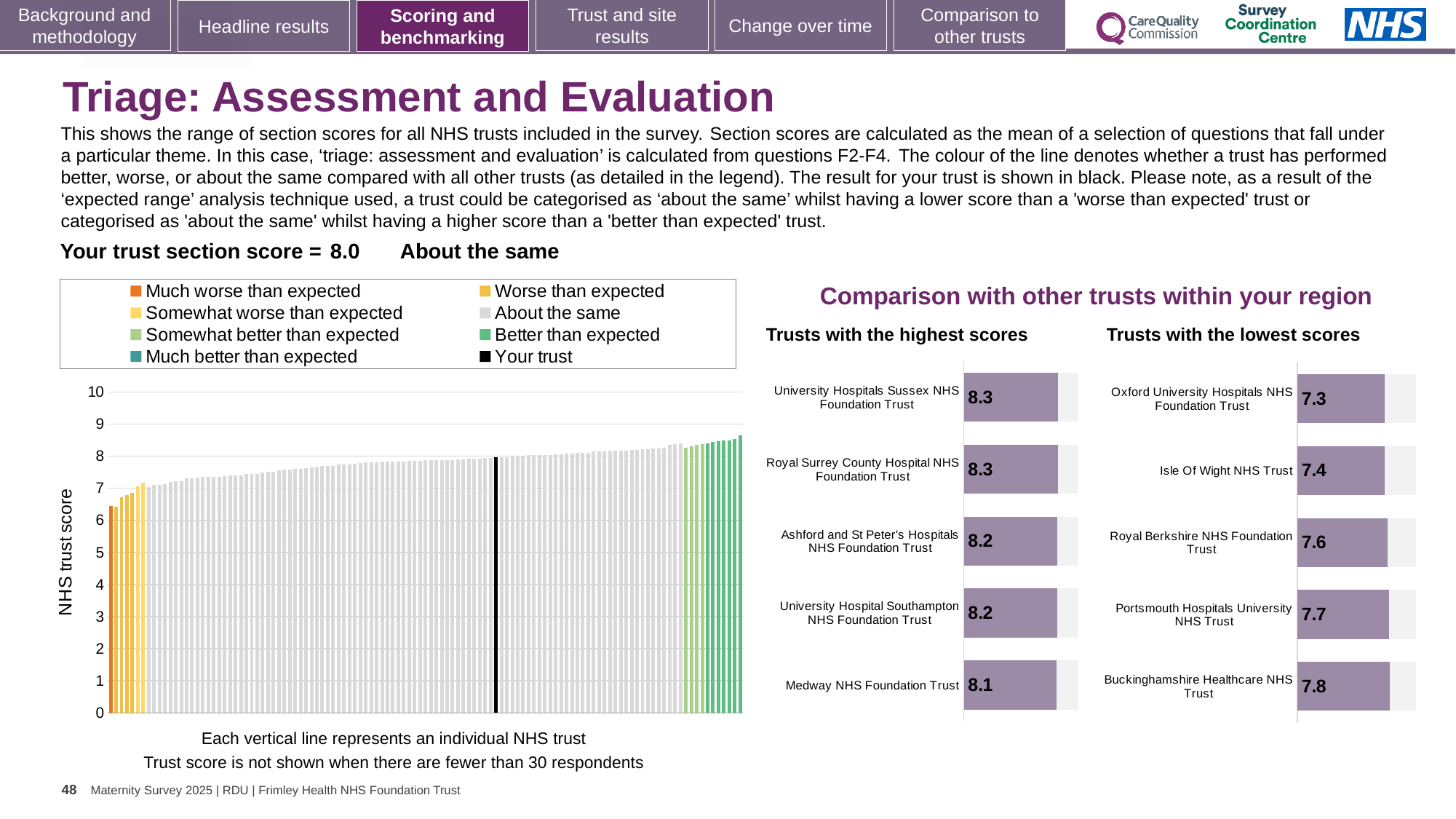
In the 'Trusts with the lowest scores' chart, what is the difference between the scores of Buckinghamshire Healthcare NHS Trust and Oxford University Hospitals NHS Foundation Trust? 0.5 In the 'Trusts with the highest scores' chart, what is the score for Medway NHS Foundation Trust? 8.1 What kind of chart is the main 'NHS trust score' chart on the left? Bar chart In the 'Trusts with the lowest scores' chart, which has the higher score: Portsmouth Hospitals University NHS Trust or Royal Berkshire NHS Foundation Trust? Portsmouth Hospitals University NHS Trust In the 'Trusts with the lowest scores' chart, which trust has the lowest score? Oxford University Hospitals NHS Foundation Trust How many trusts are shown in the 'Trusts with the highest scores' chart? 5 How many entries does the legend of the main 'NHS trust score' chart list? 8 In the 'Trusts with the highest scores' chart, what is the difference between the scores of University Hospitals Sussex NHS Foundation Trust and Medway NHS Foundation Trust? 0.2 In the 'Trusts with the lowest scores' chart, what is the score for Royal Berkshire NHS Foundation Trust? 7.6 In the 'Trusts with the lowest scores' chart, what is the score for Isle Of Wight NHS Trust? 7.4 In the main 'NHS trust score' chart, do the trust scores rise or fall from left to right? Rise In the 'Trusts with the lowest scores' chart, which trust has the highest score? Buckinghamshire Healthcare NHS Trust